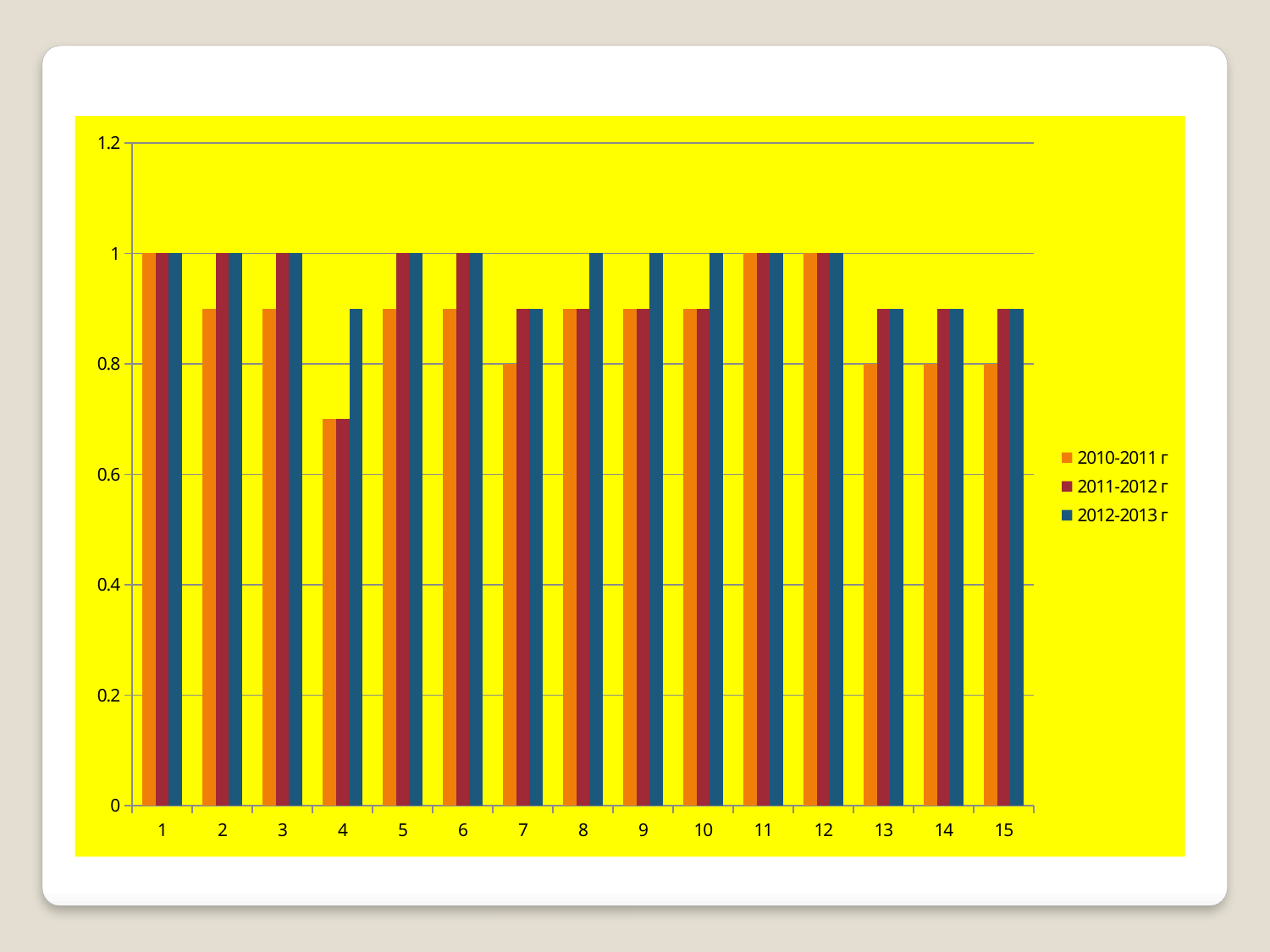
What is the value for series 2012-2013 г at category 11? 1 Is the value for series 2012-2013 г at category 4 greater or less than 0.8? greater What is the value for series 2010-2011 г at category 7? 0.8 For series 2010-2011 г, which category has the lowest value? 4 What is the value for series 2010-2011 г at category 1? 1 What kind of chart is shown on the slide? bar chart How many series does the legend list? 3 What is the difference between the 2010-2011 г value at category 1 and at category 7? 0.2 Is the value for series 2010-2011 г at category 4 greater or less than 0.8? less What are the three entries listed in the legend? 2010-2011 г, 2011-2012 г, 2012-2013 г At category 4, which series has the larger value: 2010-2011 г or 2012-2013 г? 2012-2013 г How many categories are shown on the x axis? 15